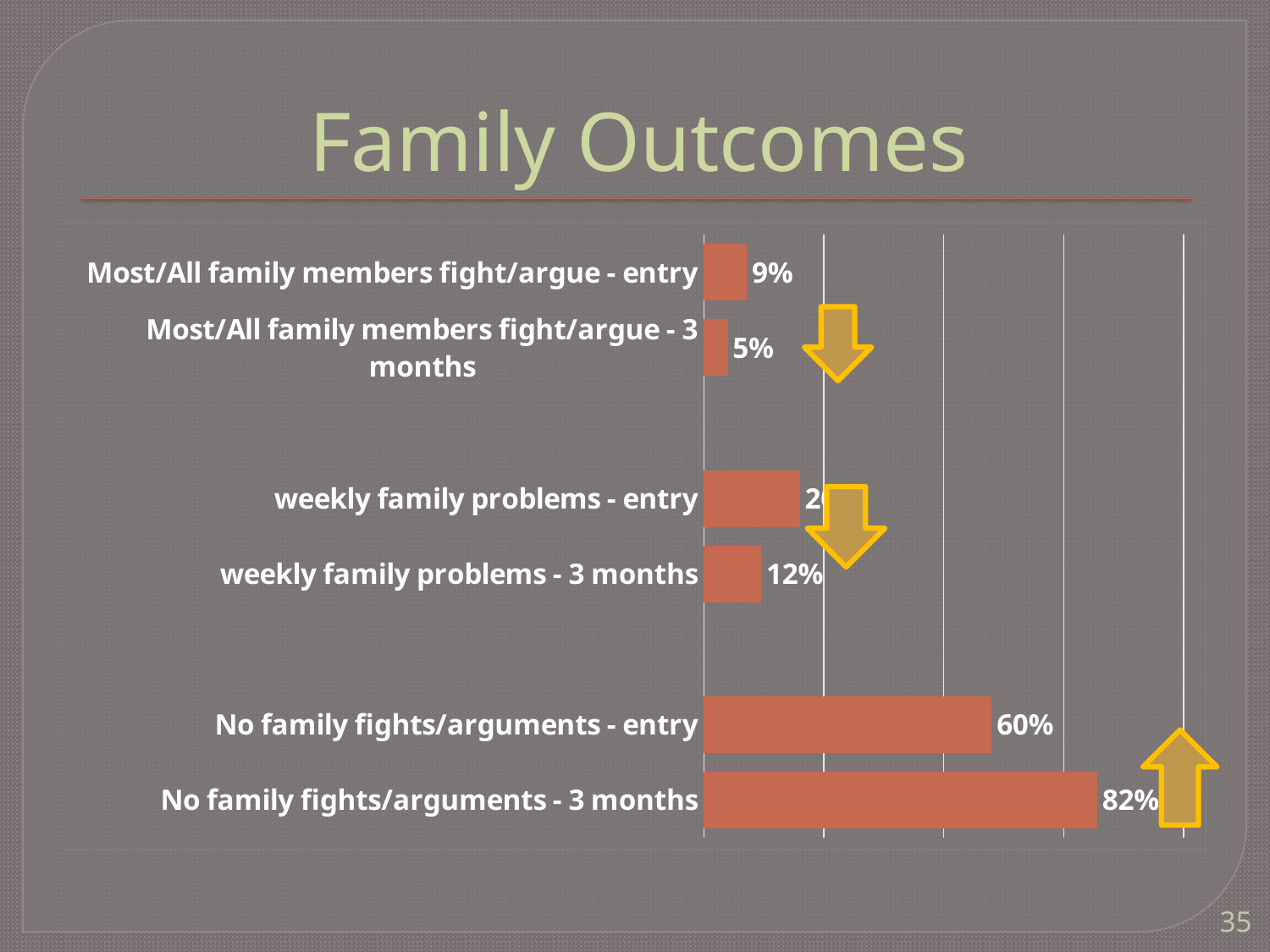
How many categories are shown in the chart? 6 Which is larger: the value for "weekly family problems - entry" or "weekly family problems - 3 months"? weekly family problems - entry What is the value for "Most/All family members fight/argue - entry"? 9% What is the difference between the values for "No family fights/arguments - 3 months" and "No family fights/arguments - entry"? 22% What is the value for "weekly family problems - 3 months"? 12% Which category has the lowest value? Most/All family members fight/argue - 3 months What is the value for "Most/All family members fight/argue - 3 months"? 5% Which category has the highest value? No family fights/arguments - 3 months What is the value for "No family fights/arguments - 3 months"? 82% What is the value for "No family fights/arguments - entry"? 60% What kind of chart is shown on the slide? Bar chart What is the difference between the values for "Most/All family members fight/argue - entry" and "Most/All family members fight/argue - 3 months"? 4%